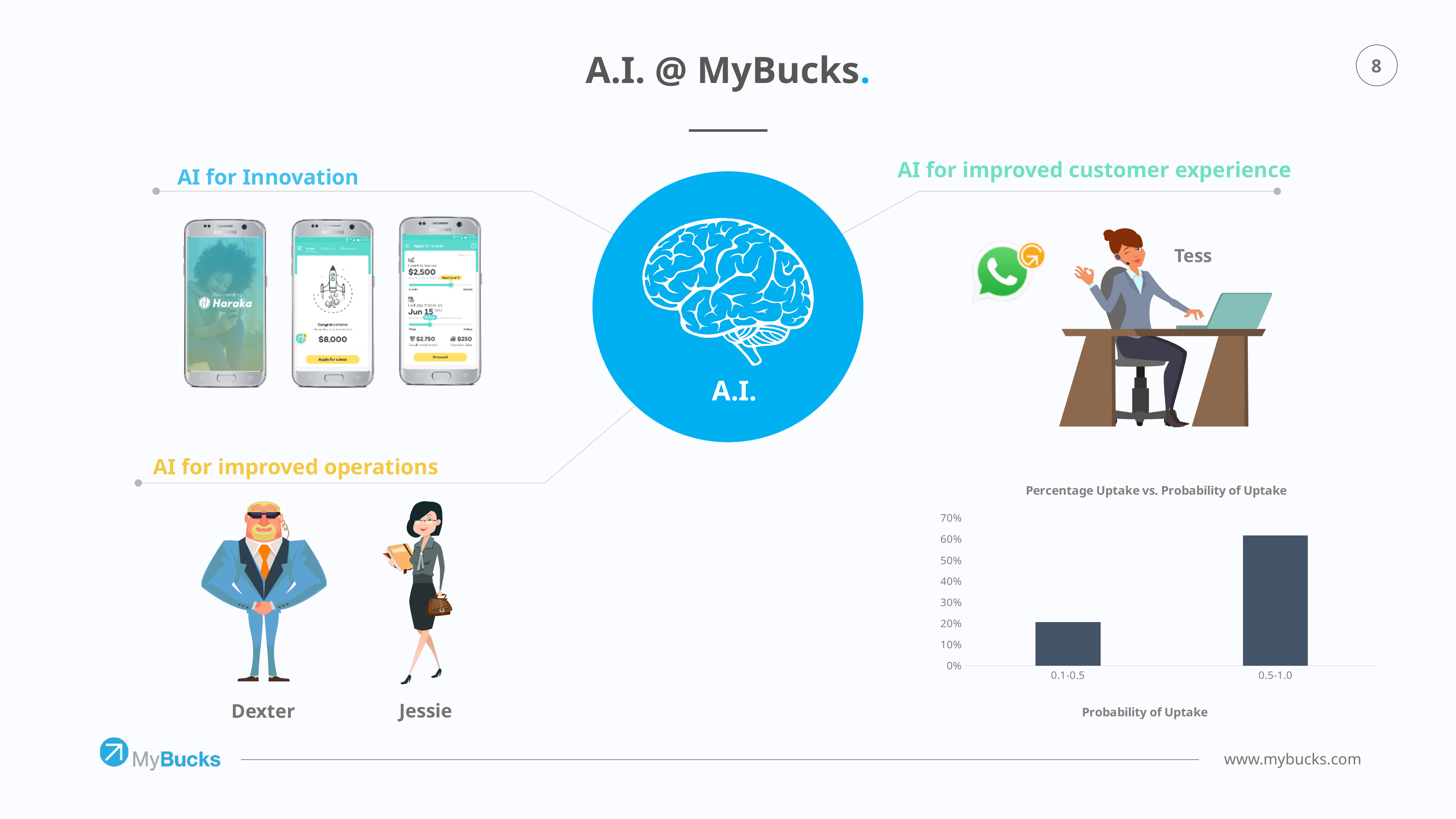
In the 'Percentage Uptake vs. Probability of Uptake' chart, do the values rise or fall from 0.1-0.5 to 0.5-1.0? rise In the 'Percentage Uptake vs. Probability of Uptake' chart, which category has the lowest value? 0.1-0.5 What is the x-axis title of the 'Percentage Uptake vs. Probability of Uptake' chart? Probability of Uptake In the 'Percentage Uptake vs. Probability of Uptake' chart, which is larger: the value for 0.1-0.5 or the value for 0.5-1.0? 0.5-1.0 In the 'Percentage Uptake vs. Probability of Uptake' chart, is the value for 0.1-0.5 greater or less than 10%? greater How many categories are plotted in the 'Percentage Uptake vs. Probability of Uptake' chart? 2 In the 'Percentage Uptake vs. Probability of Uptake' chart, is the value for 0.1-0.5 greater or less than 30%? less In the 'Percentage Uptake vs. Probability of Uptake' chart, which category has the highest value? 0.5-1.0 What is the title of the chart on the slide? Percentage Uptake vs. Probability of Uptake In the 'Percentage Uptake vs. Probability of Uptake' chart, is the value for 0.5-1.0 greater or less than 50%? greater What kind of chart is shown under 'Percentage Uptake vs. Probability of Uptake'? bar chart